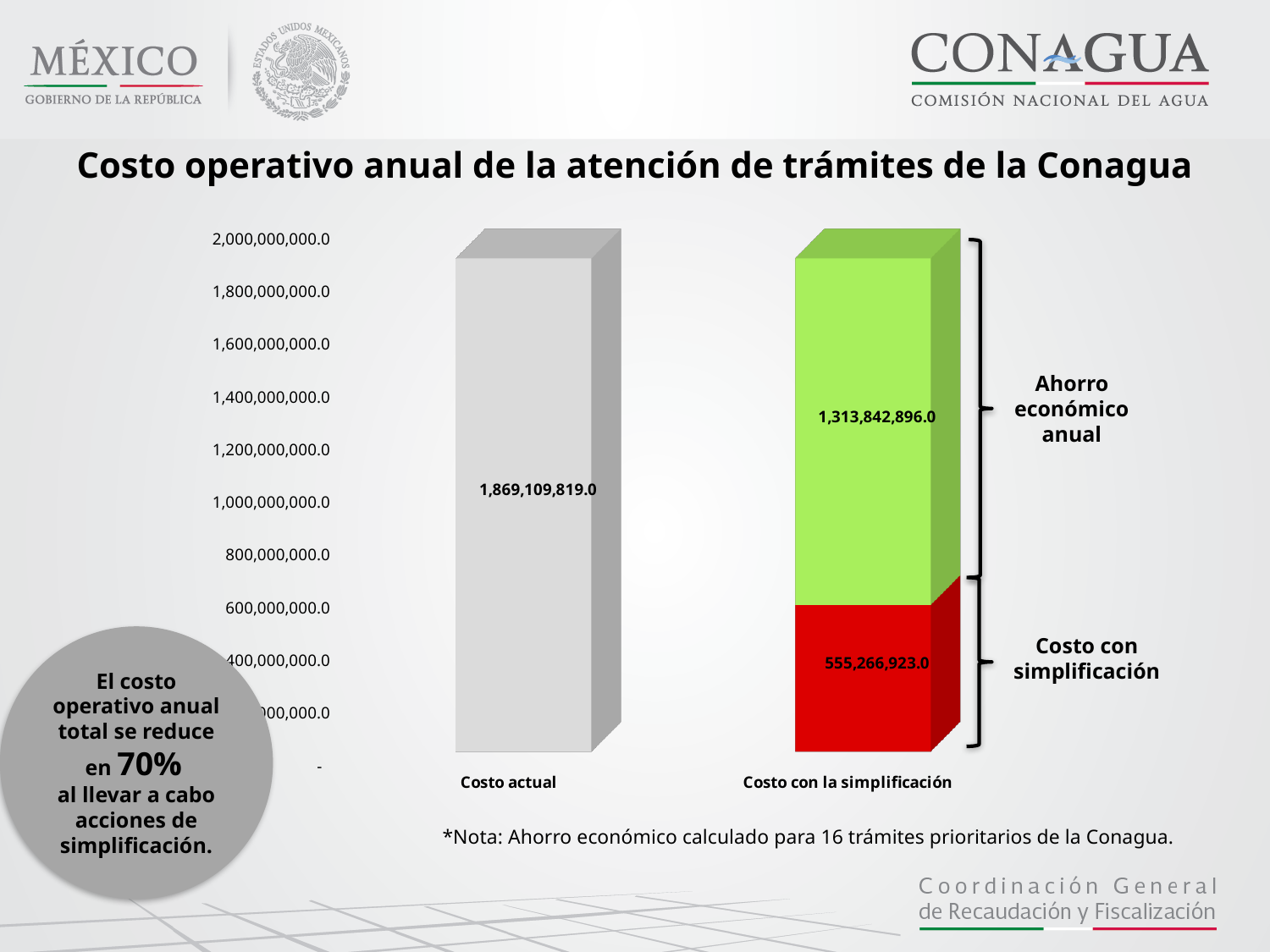
What is the difference between Costo actual and the Costo con simplificación segment? 1,313,842,896.0 What is the value of the Costo con simplificación segment in the Costo con la simplificación bar? 555,266,923.0 What kind of chart is shown on the slide? Bar chart Is the Costo con simplificación segment greater or less than 600,000,000.0? less How many categories are shown on the x axis of the chart? 2 What is the total of the stacked Costo con la simplificación bar? 1,869,109,819.0 What is the value shown for Costo actual? 1,869,109,819.0 What is the value of the Ahorro económico anual segment in the Costo con la simplificación bar? 1,313,842,896.0 Is the value for Costo actual greater or less than 1,800,000,000.0? greater What is the difference between the Ahorro económico anual segment and the Costo con simplificación segment? 758,575,973.0 Which segment of the Costo con la simplificación bar is larger, Ahorro económico anual or Costo con simplificación? Ahorro económico anual What colour is the Costo con simplificación segment of the stacked bar? Red